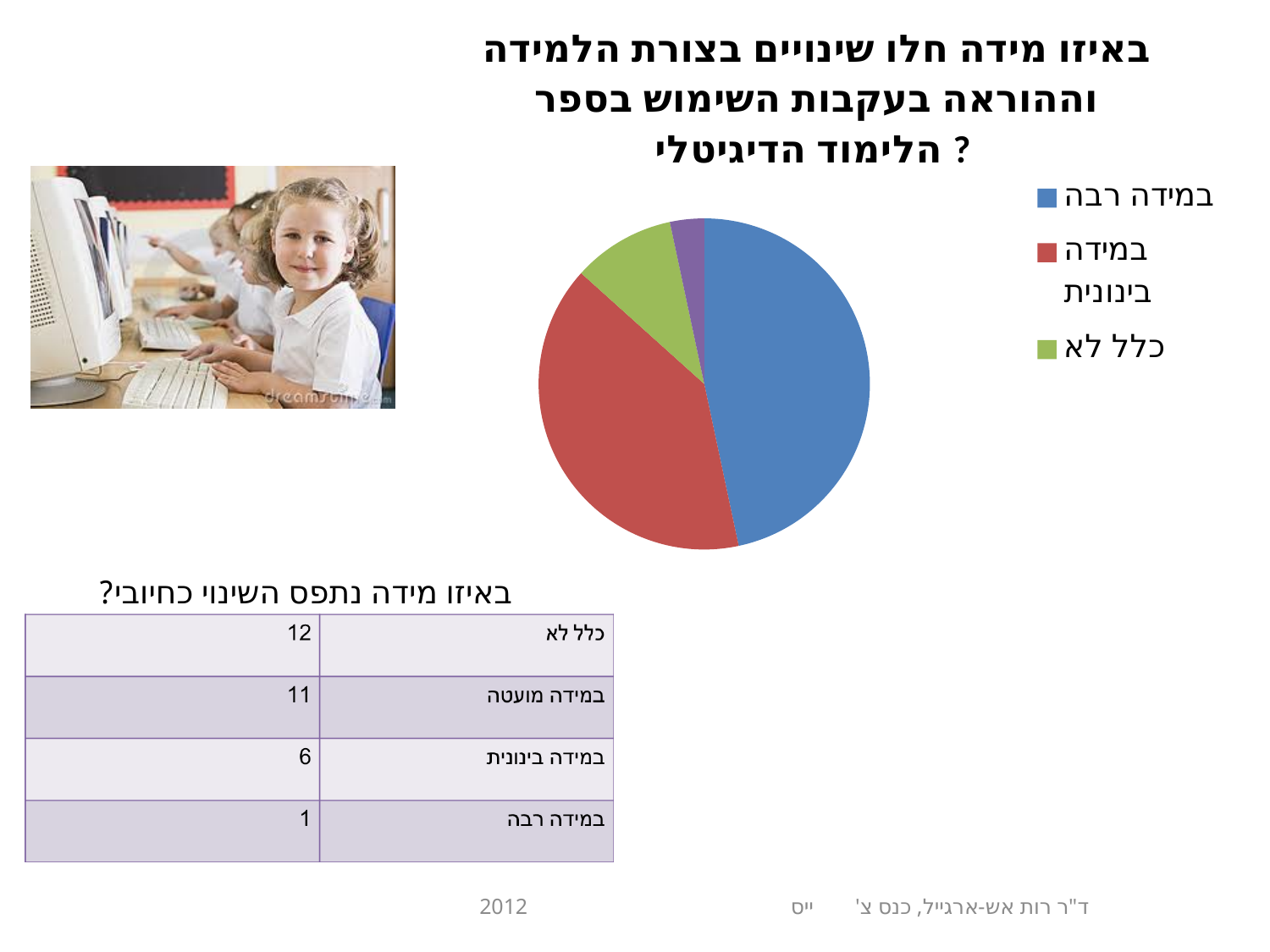
What colour is the slice for במידה רבה in the pie chart? blue Which legend category has the largest slice in the pie chart? במידה רבה In the pie chart, which slice is larger: במידה רבה or במידה בינונית? במידה רבה In the pie chart, which slice is larger: במידה בינונית or כלל לא? במידה בינונית How many slices does the pie chart have? 4 What colour is the slice for כלל לא in the pie chart? green What kind of chart is shown on the slide? pie chart How many entries does the legend of the pie chart list? 3 In the pie chart, which slice is larger: כלל לא or במידה רבה? במידה רבה Of the categories listed in the legend, which has the smallest slice in the pie chart? כלל לא